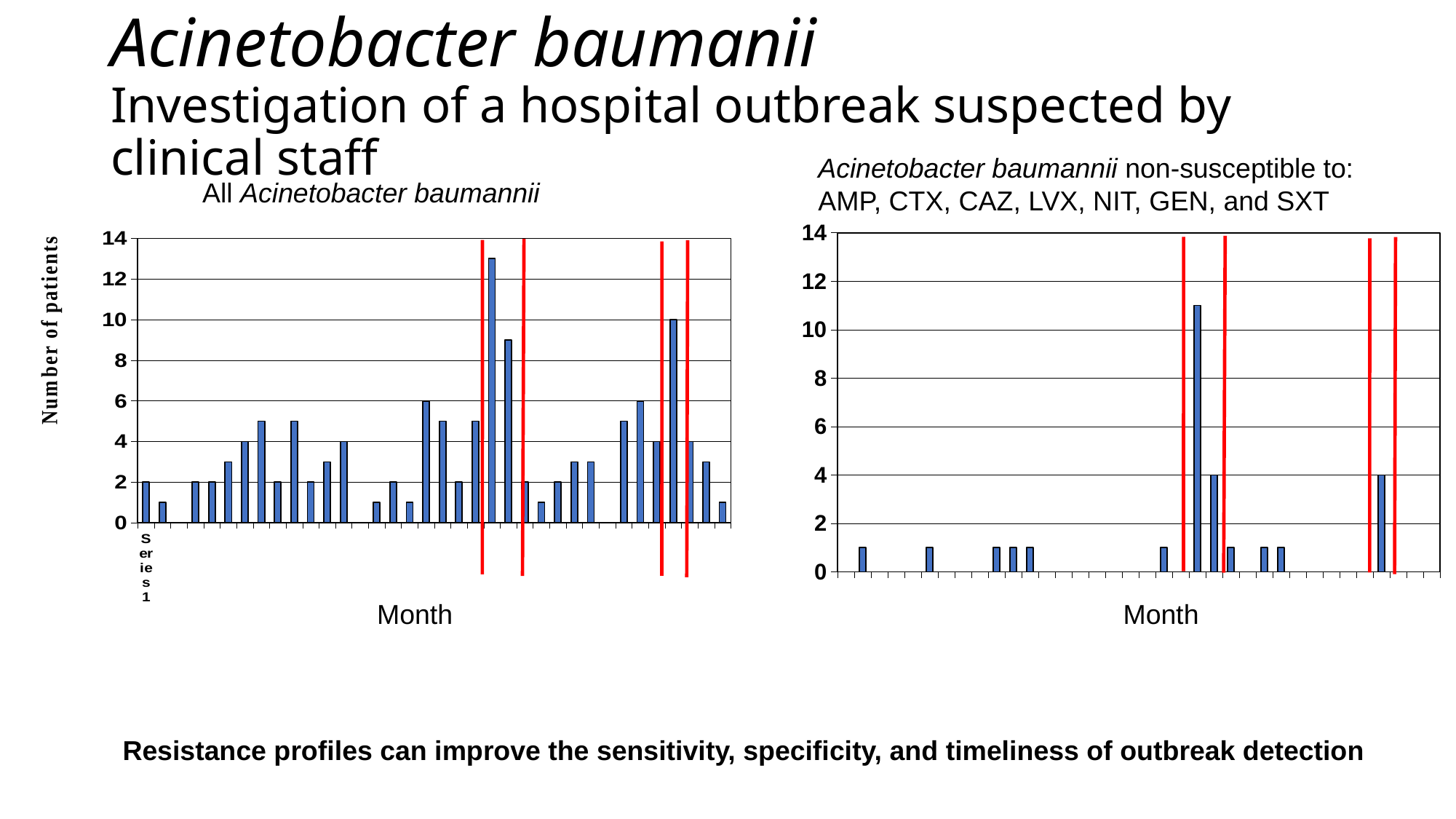
In the left chart (All Acinetobacter baumannii), is the tallest bar greater or less than 12? greater In the left chart (All Acinetobacter baumannii), are the shortest bars greater or less than 2? less In the right chart (non-susceptible isolates), is the tallest bar greater or less than 10? greater What is the y-axis label of the left chart (All Acinetobacter baumannii)? Number of patients What kind of chart is the left chart titled "All Acinetobacter baumannii"? bar chart What kind of chart is the right chart, showing Acinetobacter baumannii non-susceptible to AMP, CTX, CAZ, LVX, NIT, GEN, and SXT? bar chart Which chart has the taller peak bar, the left chart (All Acinetobacter baumannii) or the right chart (non-susceptible isolates)? the left chart (All Acinetobacter baumannii) How many bars in the left chart (All Acinetobacter baumannii) rise above the 12 gridline? 1 How many bars in the right chart (non-susceptible isolates) rise above the 10 gridline? 1